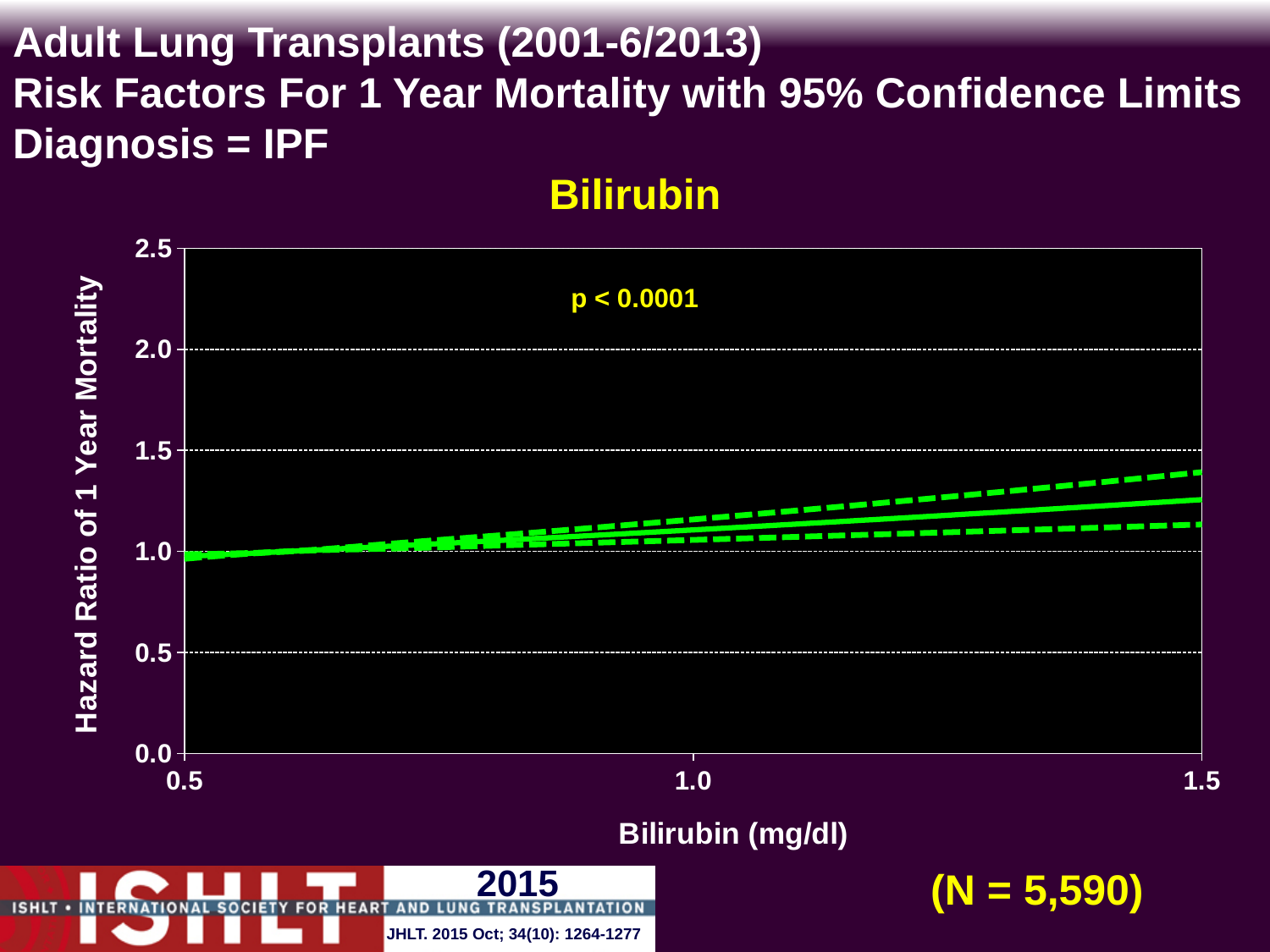
Is the lower 95% confidence limit (lower dashed line) at a bilirubin of 1.5 mg/dl greater or less than 1.0? greater What is the title of the chart? Bilirubin What kind of chart is shown on the slide? line chart Is the hazard ratio (solid line) at a bilirubin of 1.5 mg/dl greater or less than 1.5? less Is the upper 95% confidence limit (upper dashed line) at a bilirubin of 1.5 mg/dl greater or less than 1.5? less What is the highest value shown on the y axis? 2.5 Which is larger at a bilirubin of 1.5 mg/dl: the upper dashed confidence limit or the solid hazard ratio line? the upper dashed confidence limit Does the hazard ratio rise or fall as bilirubin increases from 0.5 to 1.5 mg/dl? rise How many lines are plotted on the chart? 3 What is the label of the x axis? Bilirubin (mg/dl)